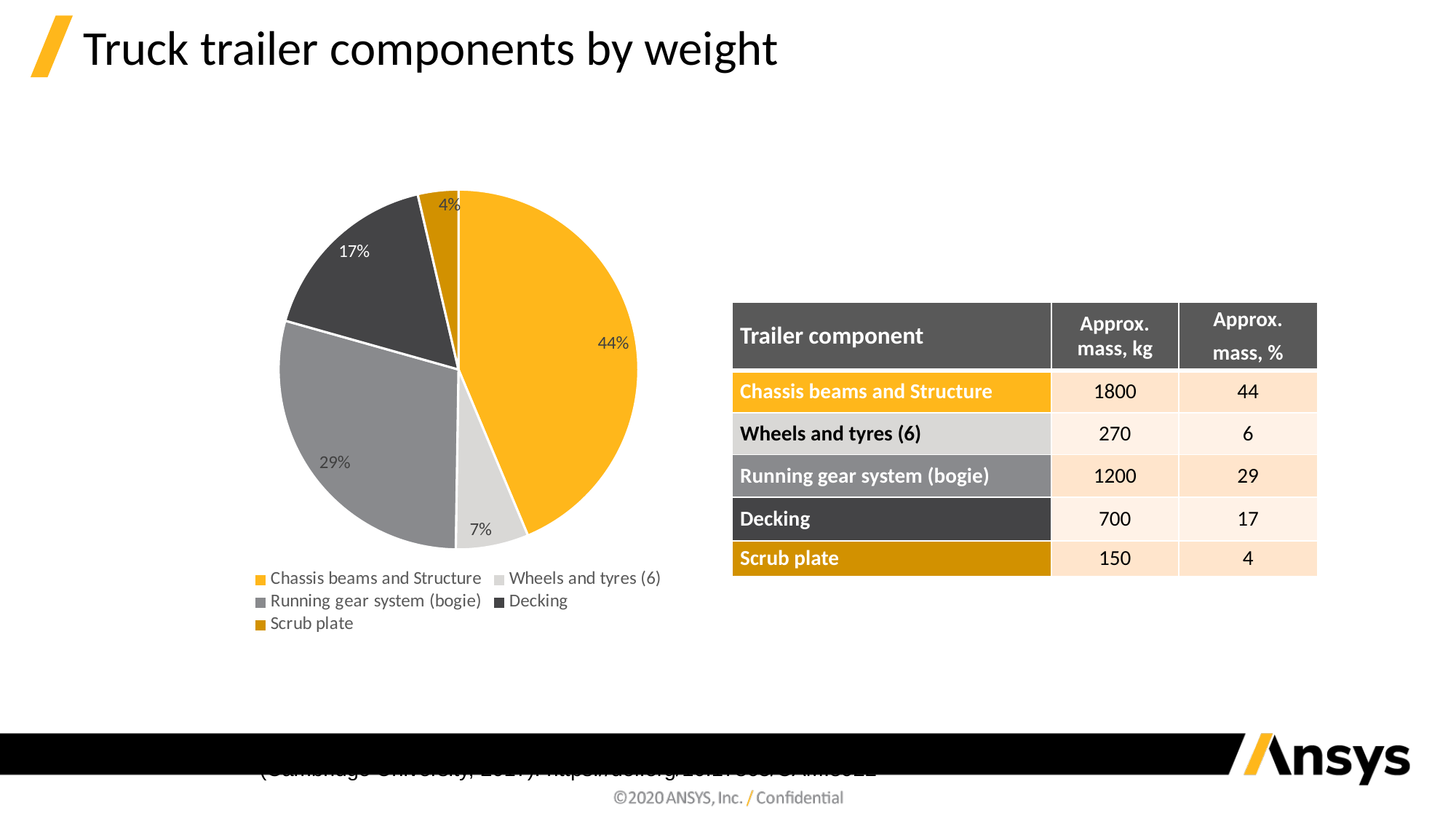
What colour is the Decking slice in the pie chart? dark grey What kind of chart is shown on the slide? pie chart What is the difference in percentage points between the Decking slice and the Scrub plate slice? 13 Which slice is larger, Running gear system (bogie) or Decking? Running gear system (bogie) What share of the pie does Scrub plate take? 4% What is the difference in percentage points between the Chassis beams and Structure slice and the Running gear system (bogie) slice? 15 What share of the pie does Chassis beams and Structure take? 44% What share of the pie does Running gear system (bogie) take? 29% How many slices does the pie chart have? 5 Which component has the smallest slice of the pie? Scrub plate Which component has the largest slice of the pie? Chassis beams and Structure